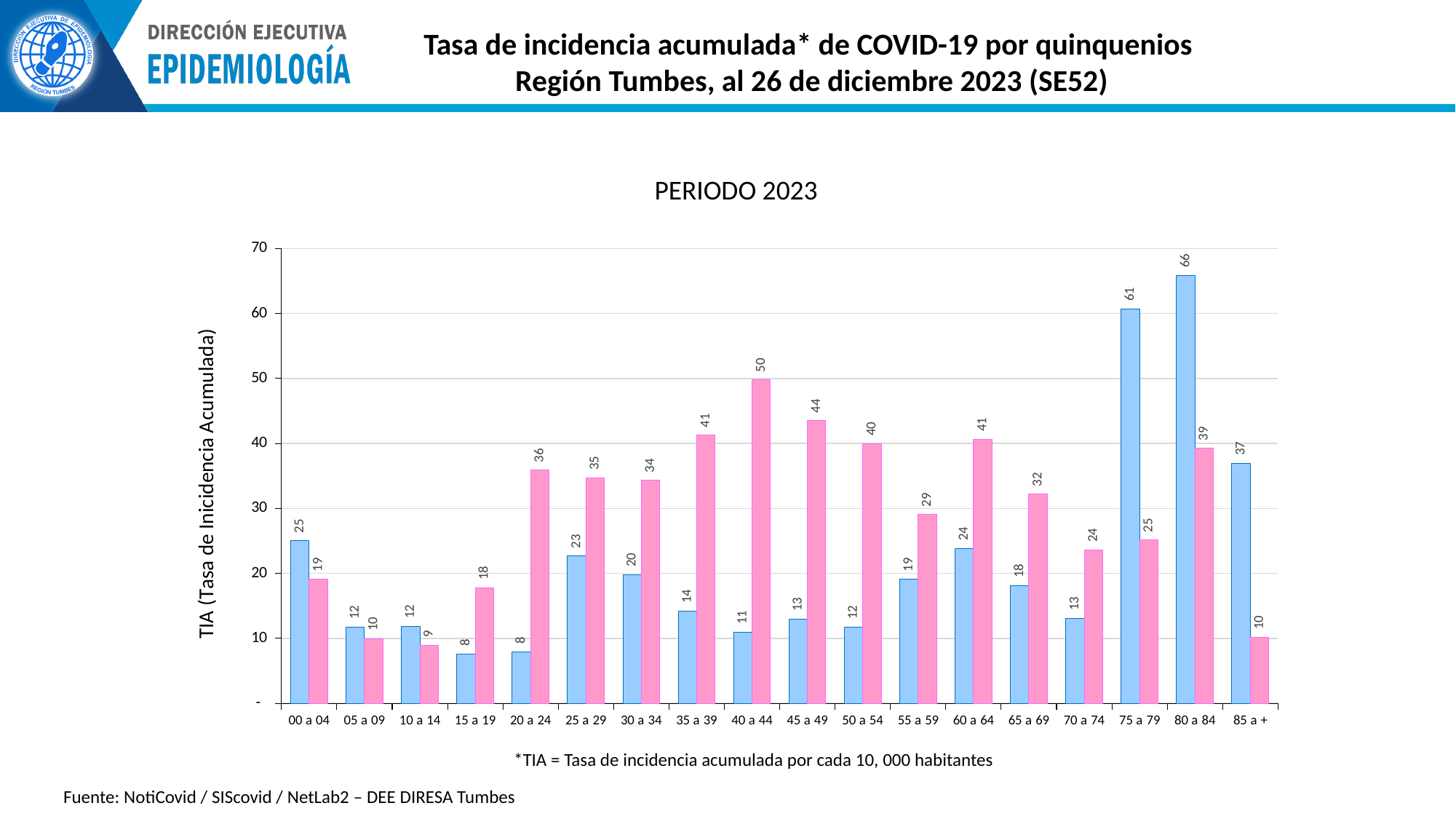
Which age group has the highest pink bar? 40 a 44 What is the title shown above the chart? PERIODO 2023 What is the difference between the blue and pink bars for the 75 a 79 age group? 36 How many age groups are shown on the x axis? 18 What type of chart is shown on the slide? bar chart Which age group has the lowest pink bar? 10 a 14 Is the value of the blue bar for 75 a 79 greater or less than 50? greater What is the value of the blue bar for the 80 a 84 age group? 66 What is the value of the pink bar for the 40 a 44 age group? 50 Which age group has the highest blue bar? 80 a 84 For the 20 a 24 age group, which bar is larger, blue or pink? pink What is the value of the blue bar for the 85 a + age group? 37